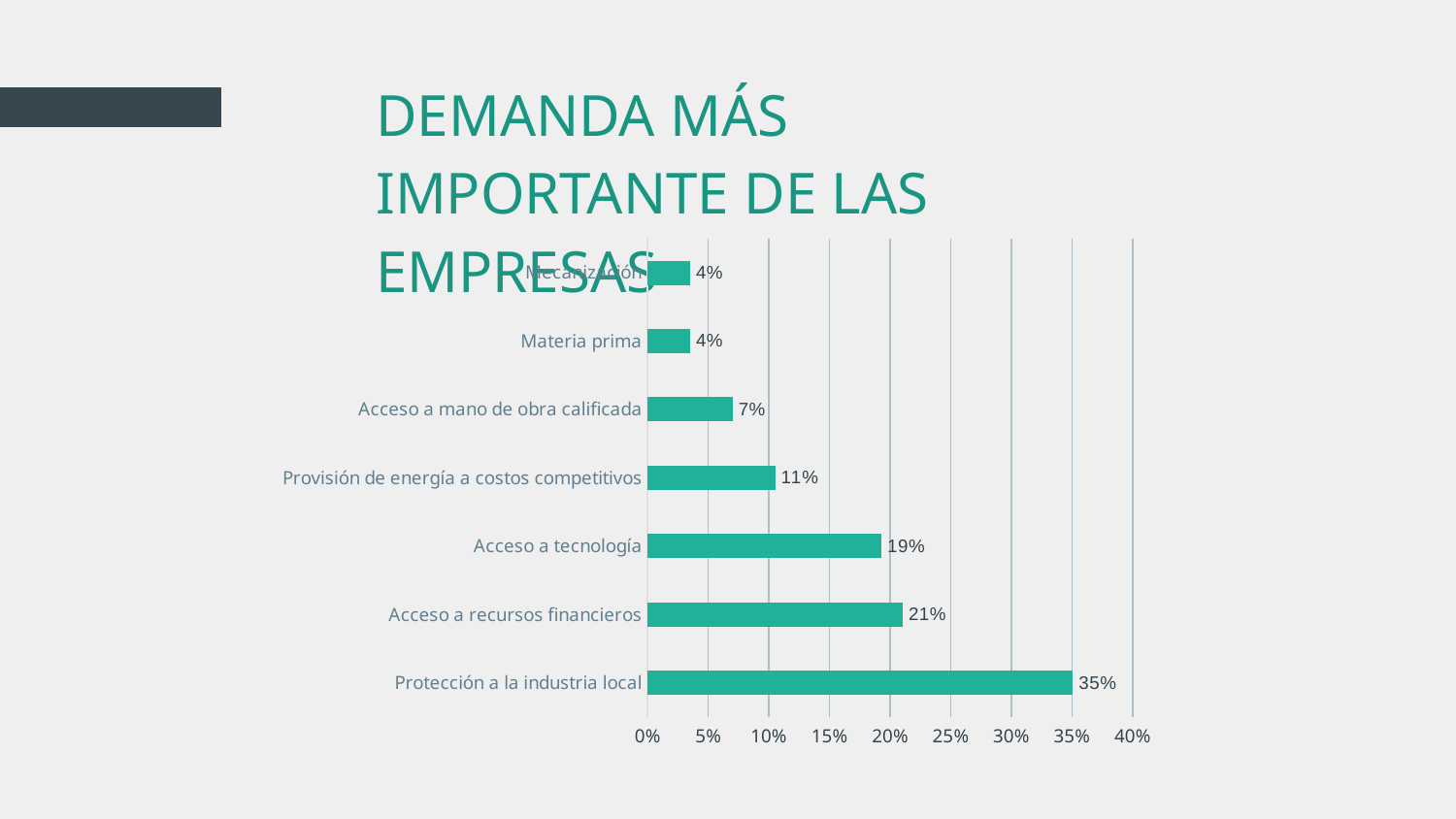
What is the value for Acceso a tecnología? 19% What is the value for Materia prima? 4% What is the value for Provisión de energía a costos competitivos? 11% How many categories are plotted in the chart? 7 What is the value for Acceso a recursos financieros? 21% What type of chart is shown on the slide? bar chart What is the title of the slide? DEMANDA MÁS IMPORTANTE DE LAS EMPRESAS What is the value for Protección a la industria local? 35% Which is larger, Acceso a tecnología or Provisión de energía a costos competitivos? Acceso a tecnología What is the value for Acceso a mano de obra calificada? 7% Which category has the highest value? Protección a la industria local What is the difference between Protección a la industria local and Acceso a recursos financieros? 14%